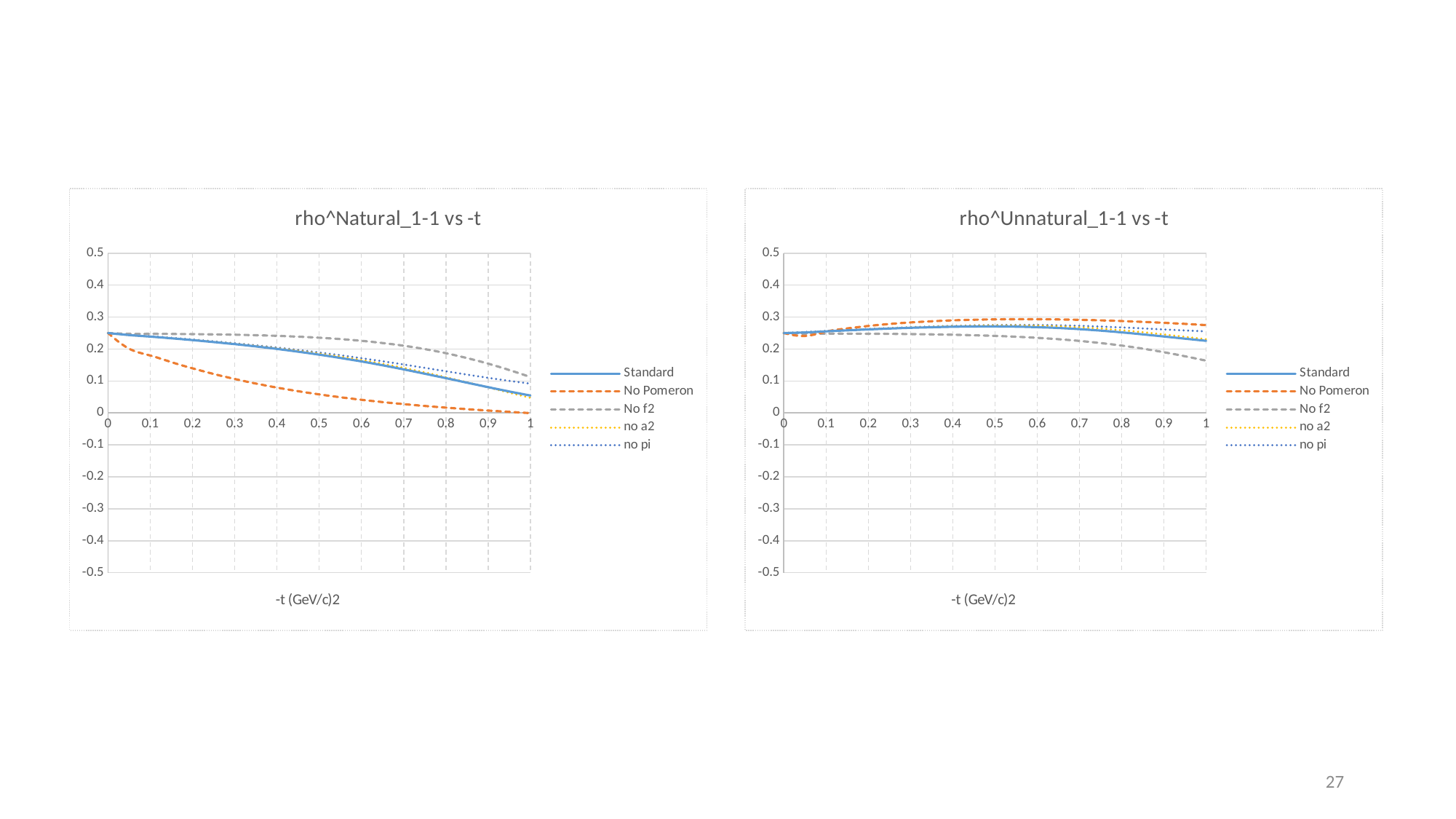
In the rho^Natural_1-1 vs -t chart, is the value of the No f2 series at -t = 0.5 greater or less than 0.2? greater How many series does the legend of the rho^Natural_1-1 vs -t chart list? 5 What is the x-axis label of the rho^Unnatural_1-1 vs -t chart? -t (GeV/c)2 What is the title of the right chart on the slide? rho^Unnatural_1-1 vs -t What kind of chart is the left chart titled rho^Natural_1-1 vs -t? line chart In the rho^Unnatural_1-1 vs -t chart, is the value of the No f2 series at -t = 1 greater or less than 0.2? less In the rho^Natural_1-1 vs -t chart, which series has the lowest value at -t = 0.5? No Pomeron In the rho^Natural_1-1 vs -t chart, is the value of the No Pomeron series at -t = 0.5 greater or less than 0.1? less In the rho^Unnatural_1-1 vs -t chart, which series has the lowest value at -t = 1? No f2 In the rho^Natural_1-1 vs -t chart, at -t = 0.5, which is larger: the No f2 series or the No Pomeron series? No f2 In the rho^Unnatural_1-1 vs -t chart, which series has the highest value at -t = 1? No Pomeron In the rho^Natural_1-1 vs -t chart, does the Standard series rise or fall as -t increases from 0 to 1? fall